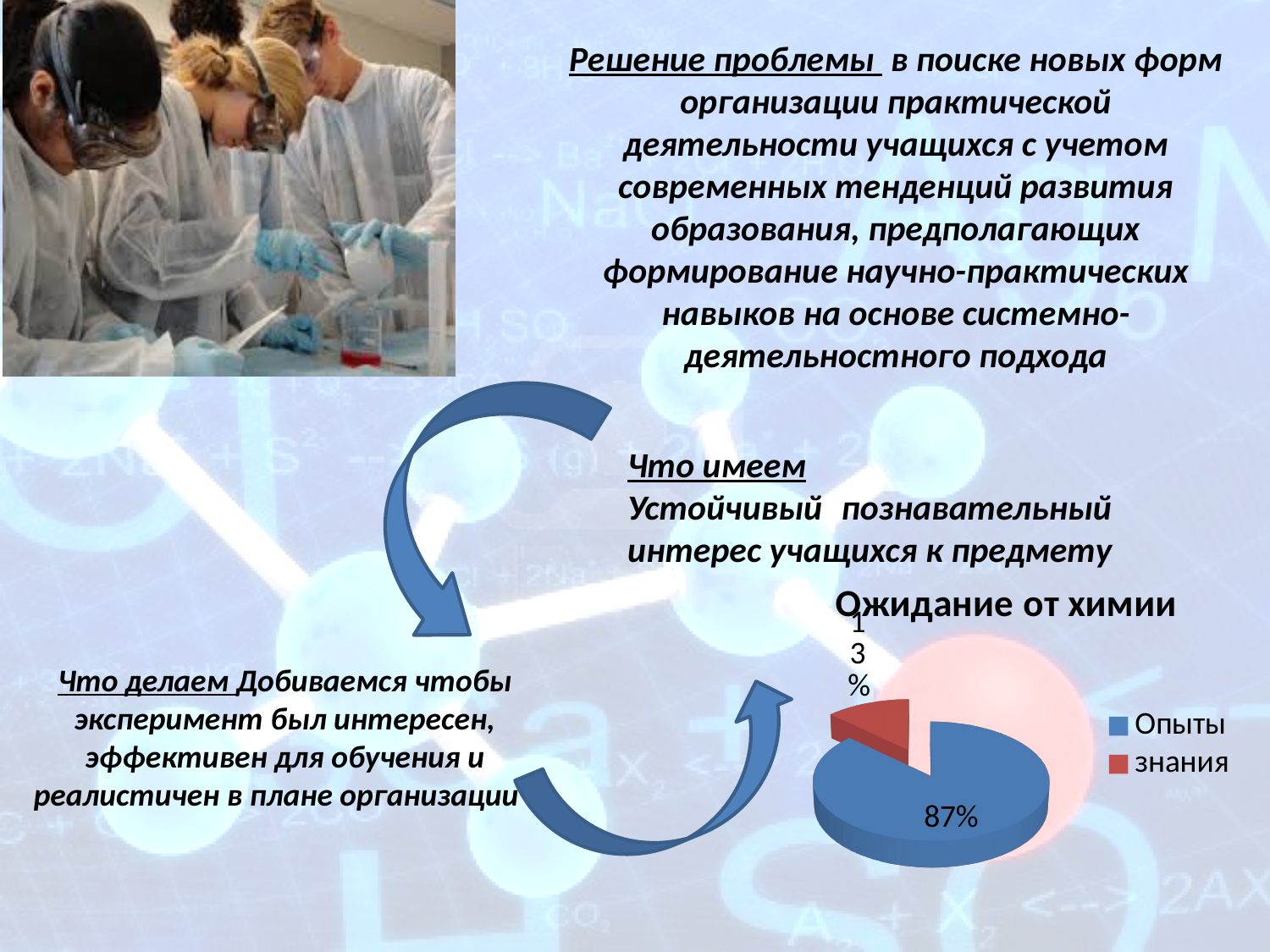
Which slice of the pie is the largest? Опыты How many entries does the chart legend list? 2 How many slices does the pie chart have? 2 What is the difference in percentage points between the "Опыты" and "знания" slices? 74 Which is larger, the share for "Опыты" or the share for "знания"? Опыты What kind of chart is shown on the slide? pie chart What share of the pie does "Опыты" take? 87% Which slice of the pie is the smallest? знания What is the title of the chart on the slide? Ожидание от химии What colour is the "знания" slice in the pie chart? red What share of the pie does "знания" take? 13%